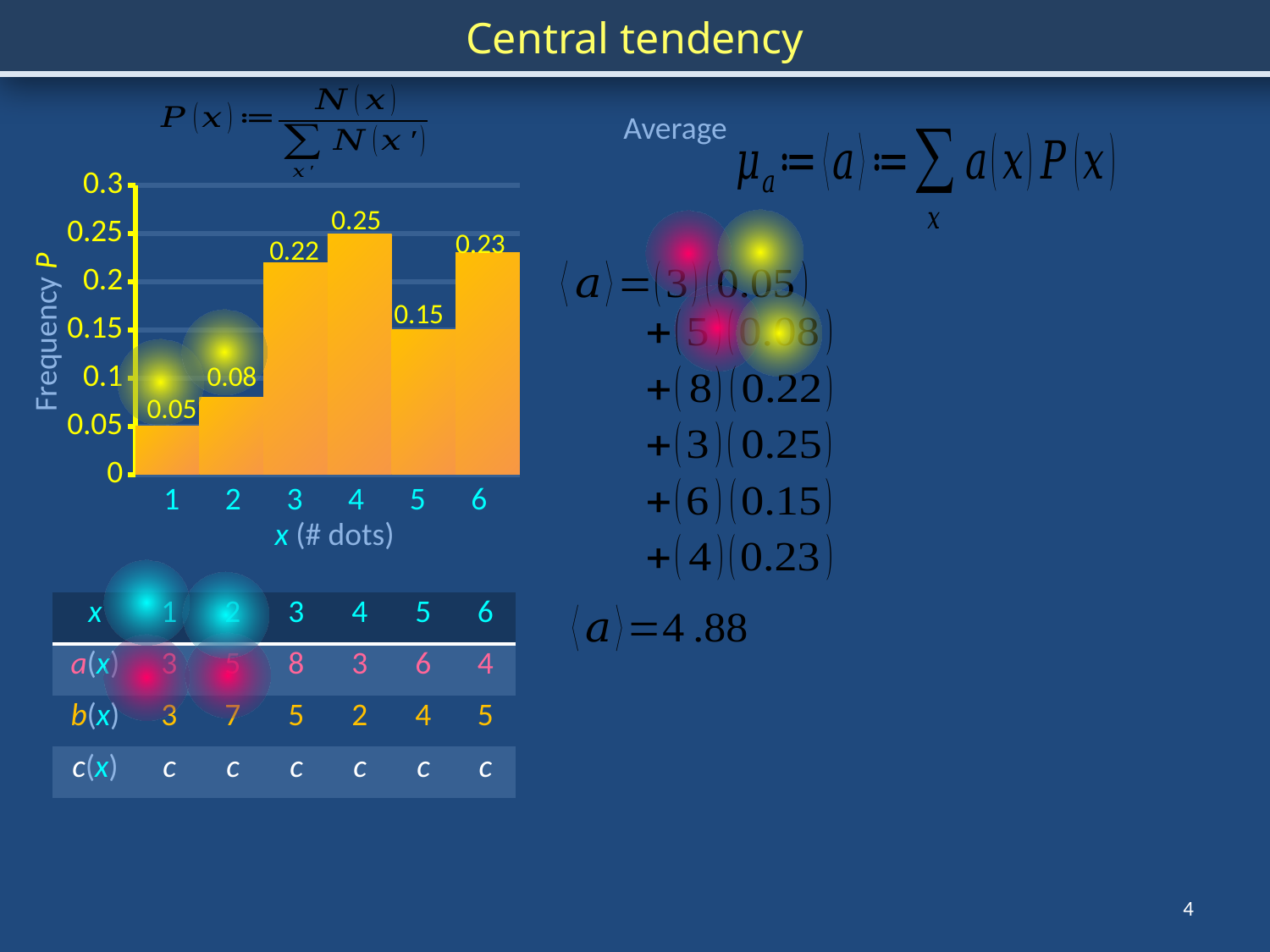
What is the frequency P for x = 4? 0.25 What kind of chart is shown on the slide? bar chart How many x categories are shown on the bar chart? 6 What is the frequency P for x = 6? 0.23 What is the difference between the frequency for x = 4 and the frequency for x = 5? 0.10 What is the frequency P for x = 1? 0.05 Which has a larger frequency P, x = 2 or x = 5? x = 5 Which value of x has the highest frequency P? 4 Which value of x has the lowest frequency P? 1 What is the frequency P for x = 3? 0.22 Is the frequency for x = 3 greater or less than 0.2? greater What is the label of the vertical axis of the chart? Frequency P